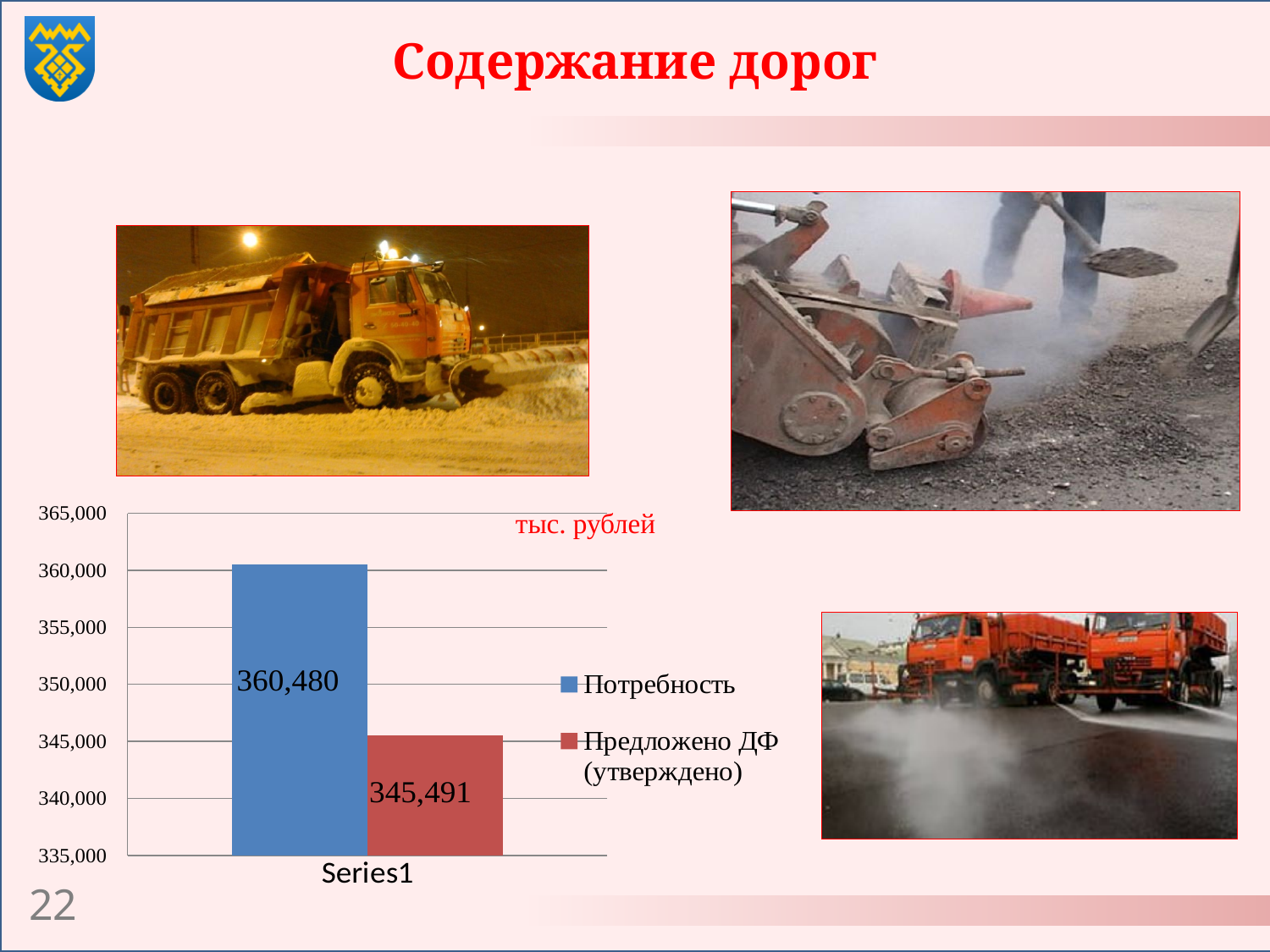
What is the category label shown on the x axis of the chart? Series1 What is the value for Потребность? 360,480 Which series has the higher value, Потребность or Предложено ДФ (утверждено)? Потребность Is the value for Потребность greater or less than 355,000? greater Is the value for Предложено ДФ (утверждено) greater or less than 350,000? less What unit is indicated on the chart? тыс. рублей What is the value for Предложено ДФ (утверждено)? 345,491 What is the difference between Потребность and Предложено ДФ (утверждено)? 14,989 What is the highest value shown on the y axis of the chart? 365,000 What kind of chart is shown on the slide? bar chart How many series does the legend list? 2 Which series has the lowest value? Предложено ДФ (утверждено)